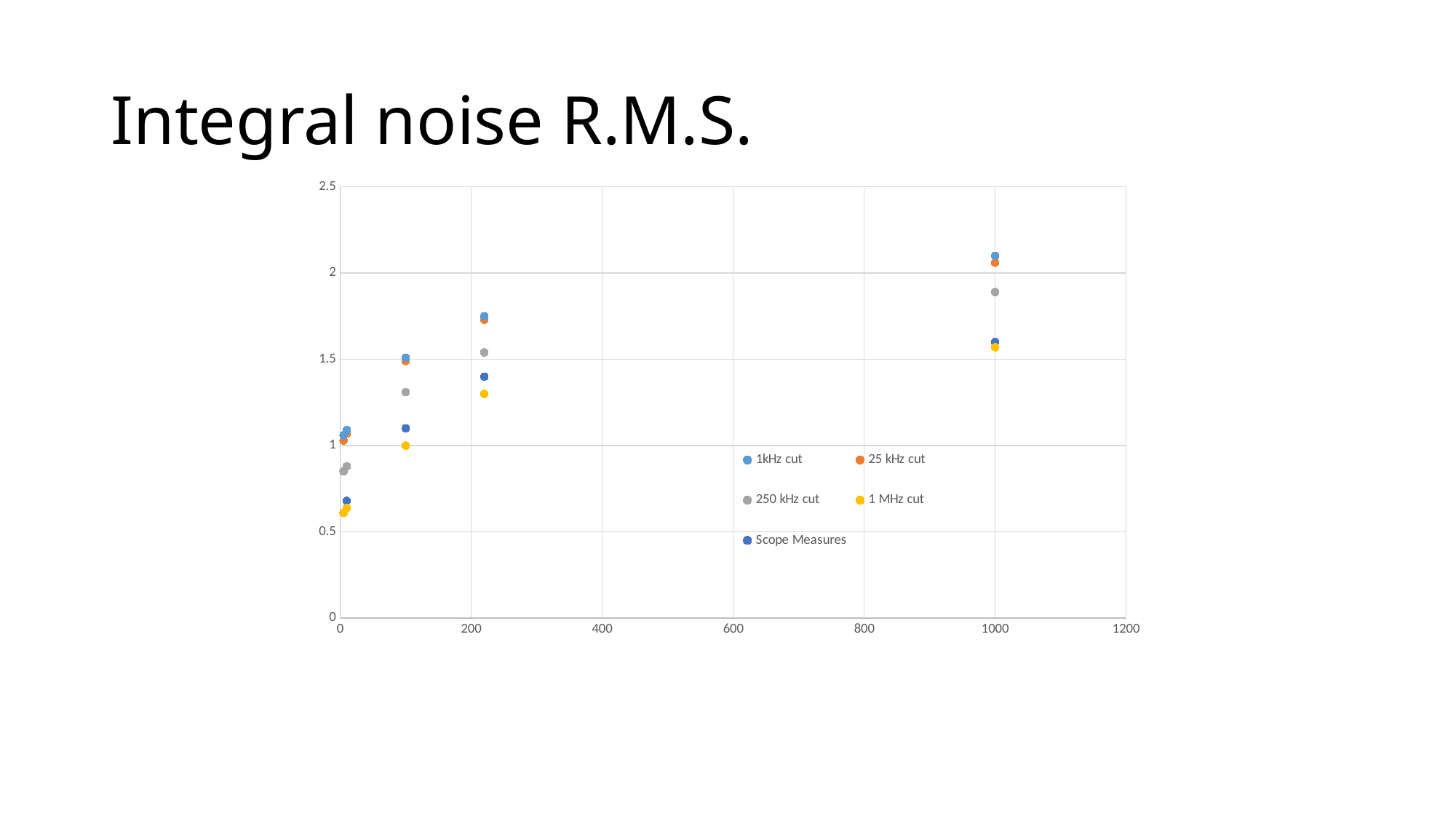
Is the value for the 250 kHz cut series at x = 100 greater or less than 1.5? less Is the value for the Scope Measures series at x = 1000 greater or less than 1.5? greater Is the value for the 1kHz cut series at x = 1000 greater or less than 2? greater Do the values of the 1kHz cut series rise or fall as x increases? rise What is the title of the slide containing the chart? Integral noise R.M.S. At x = 1000, which is larger: the 1kHz cut value or the 1 MHz cut value? 1kHz cut What kind of chart is shown on the slide? scatter chart How many series does the legend list? 5 Which series are listed in the chart legend? 1kHz cut, 25 kHz cut, 250 kHz cut, 1 MHz cut, Scope Measures At x = 100, which is larger: the 25 kHz cut value or the 1 MHz cut value? 25 kHz cut